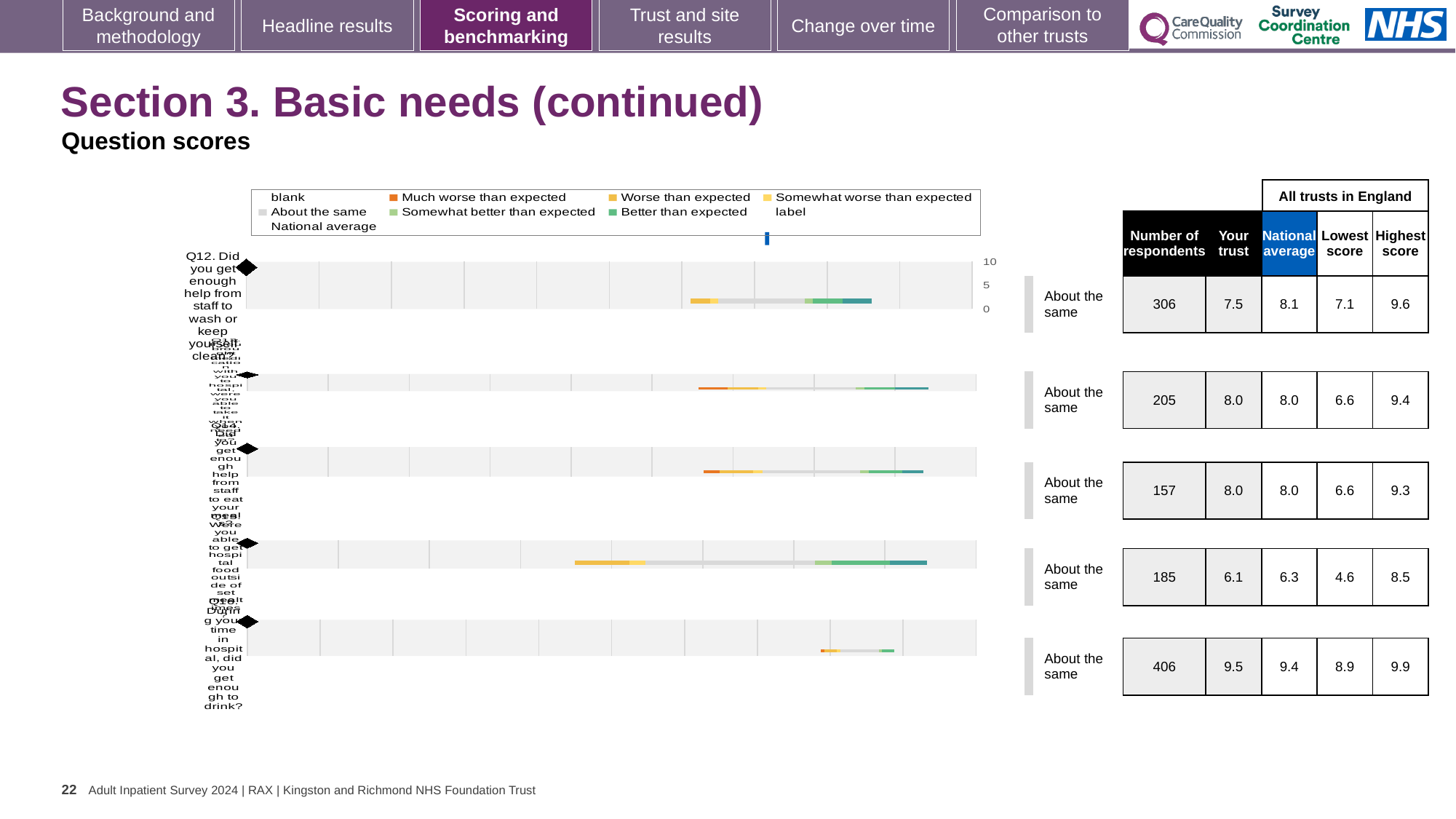
Which row of the table has the highest number of respondents, and what is that number? The bottom row, 406 What benchmark category is shown for Q12? About the same What is the national average score for Q12? 8.1 What is the difference between the highest and lowest scores for Q12? 2.5 What colour represents 'Much worse than expected' in the legend? Orange What is the 'Your trust' score in the bottom row of the table? 9.5 What kind of chart is shown on the slide? bar chart How many respondents answered Q12? 306 What is the highest score among all trusts in England for Q12? 9.6 For Q12, which is larger: the 'Your trust' score or the national average? National average How many question bars are plotted in the chart? 5 What is the 'Your trust' score for Q12 (help from staff to wash or keep yourself clean)? 7.5